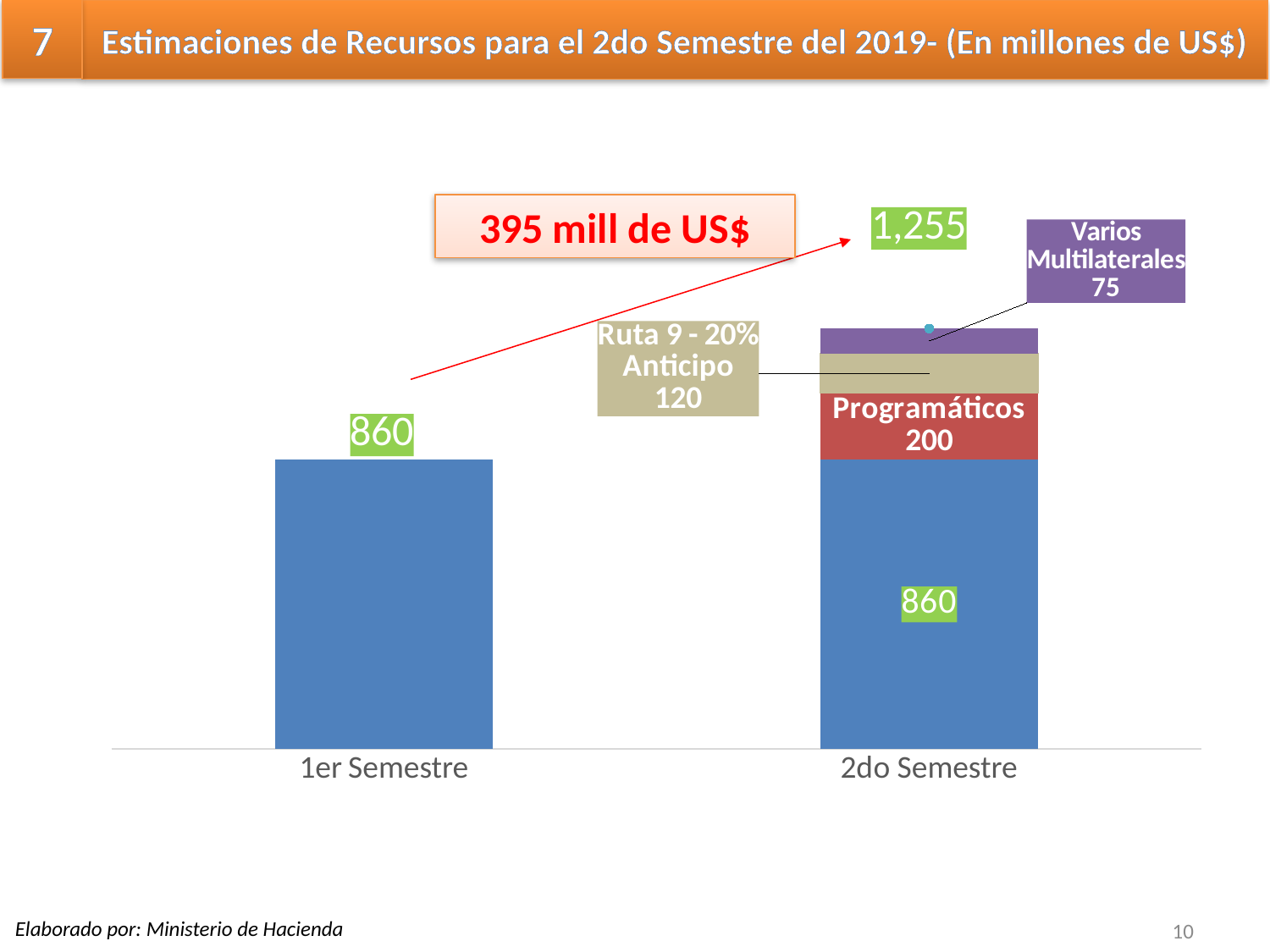
Which is larger, the Ruta 9 - 20% Anticipo segment or the Varios Multilaterales segment? Ruta 9 - 20% Anticipo What kind of chart is shown on the slide? Bar chart What is the total of the stacked 2do Semestre bar? 1,255 What is the difference between the 2do Semestre total and the 1er Semestre value? 395 What is the value of the Ruta 9 - 20% Anticipo segment in the 2do Semestre bar? 120 Which semester has the higher total value? 2do Semestre What is the value of the Programáticos segment in the 2do Semestre bar? 200 What is the value of the Varios Multilaterales segment in the 2do Semestre bar? 75 What is the difference between the Programáticos segment and the Varios Multilaterales segment? 125 What is the value of the blue base segment in the 2do Semestre bar? 860 What is the value of the 1er Semestre bar? 860 How many categories are shown on the x axis? 2